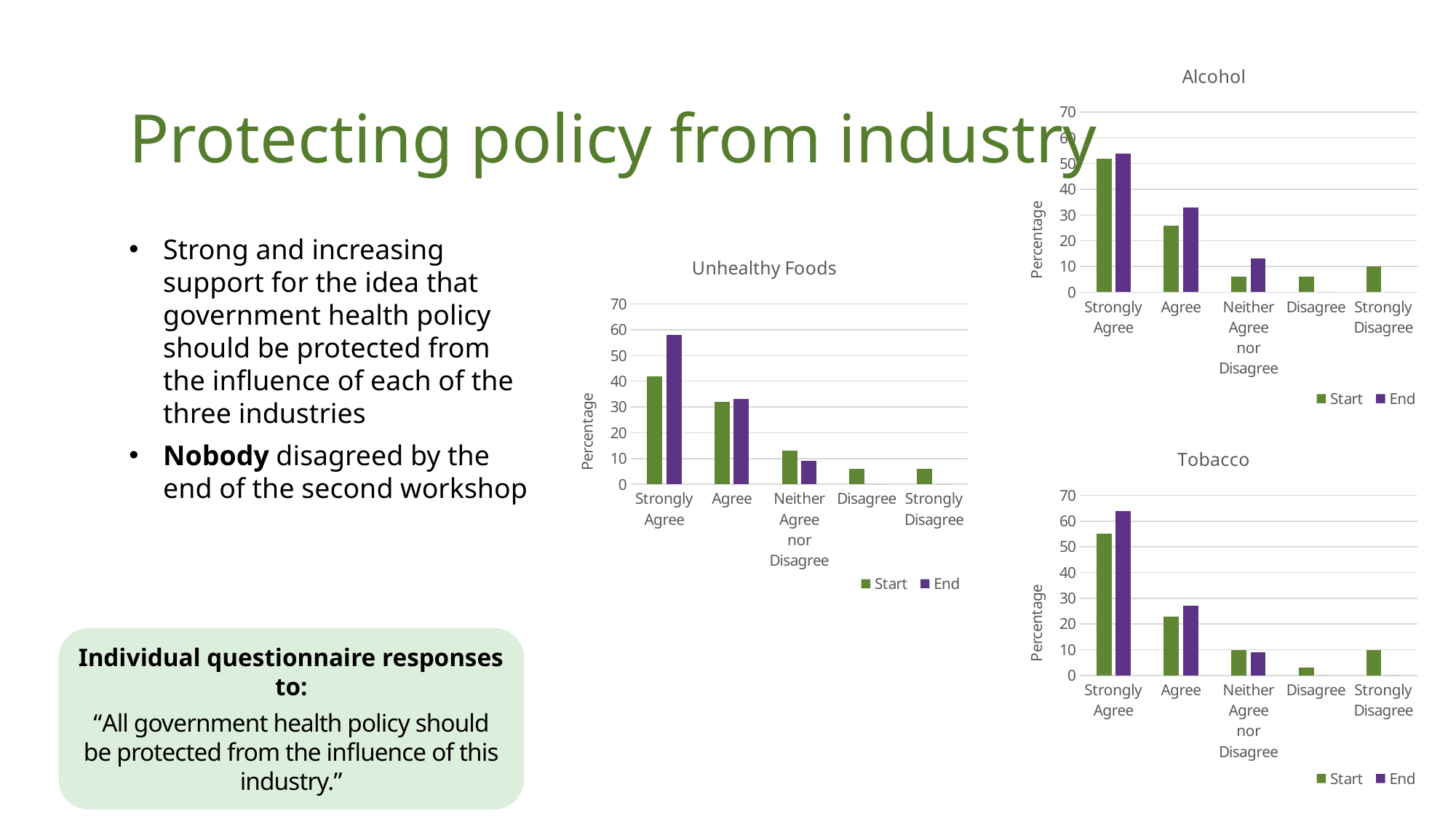
In the Tobacco chart, is the End value for Strongly Agree greater or less than 60? greater In the Unhealthy Foods chart, for Neither Agree nor Disagree, which is larger: Start or End? Start How many series does the legend of the Alcohol chart list? 2 What is the y-axis label on the Tobacco chart? Percentage In the Alcohol chart, is the Start value for Agree greater or less than 30? less In the Alcohol chart, for Agree, which is larger: Start or End? End In the Tobacco chart, which category has the highest Start value? Strongly Agree How many response categories are shown on the x axis of the Tobacco chart? 5 In the Unhealthy Foods chart, which category has the highest End value? Strongly Agree In the Unhealthy Foods chart, is the Start value for Strongly Agree greater or less than 50? less What kind of chart is the Unhealthy Foods chart? bar chart